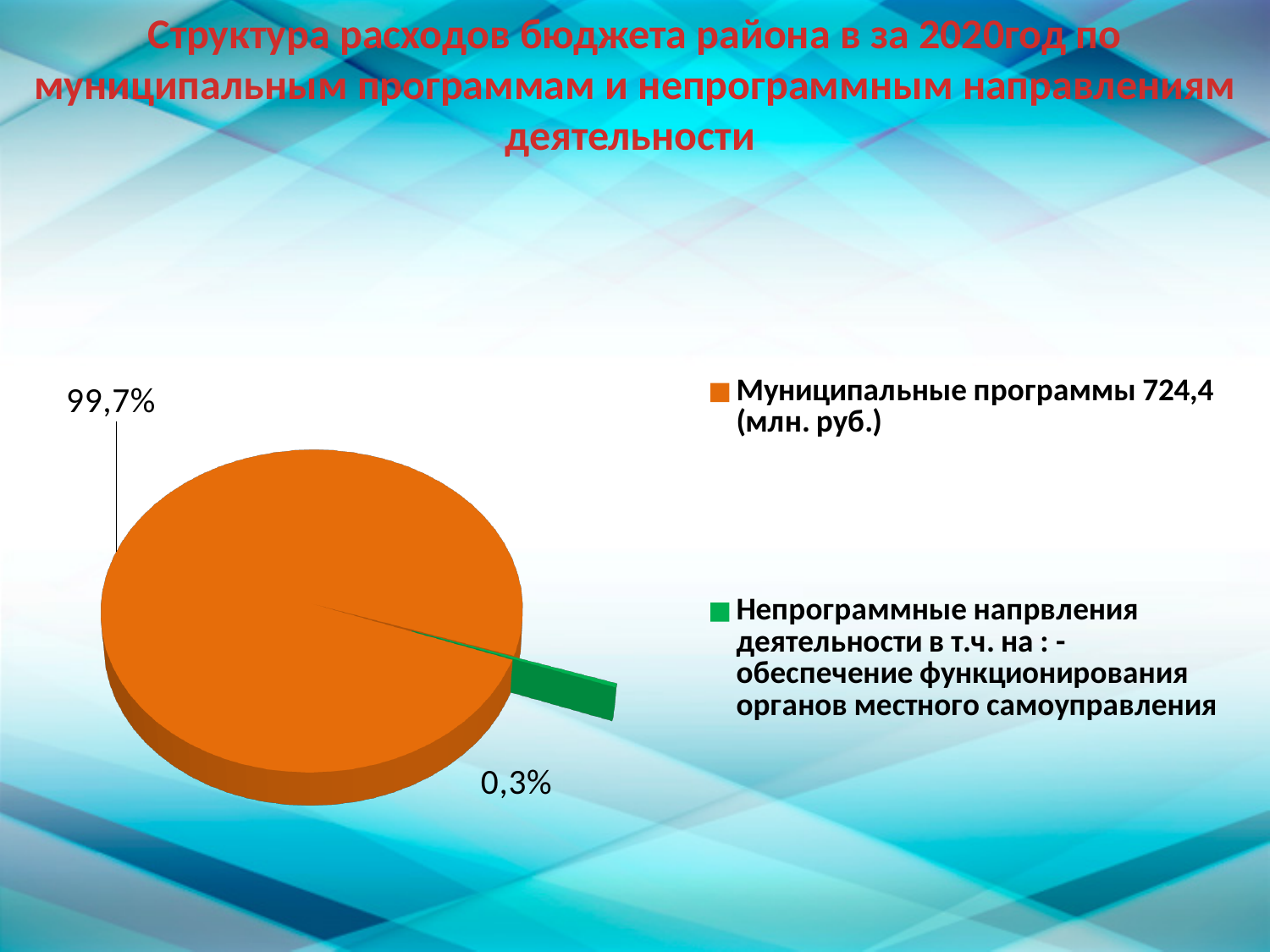
What is the difference in percentage points between the Муниципальные программы slice and the Непрограммные напрвления деятельности slice? 99,4 What share of the pie is labelled for Непрограммные напрвления деятельности? 0,3% How many slices does the pie chart have? 2 What kind of chart is shown on the slide? Pie chart How many entries does the legend list? 2 What amount in million rubles is given in the legend for Муниципальные программы? 724,4 What share of the pie is labelled for Муниципальные программы? 99,7% Which category has the largest slice of the pie? Муниципальные программы Which slice is larger: Муниципальные программы or Непрограммные напрвления деятельности? Муниципальные программы What colour is the slice for Муниципальные программы? Orange Is the share for Муниципальные программы greater or less than 50%? greater Which category has the smallest slice of the pie? Непрограммные напрвления деятельности